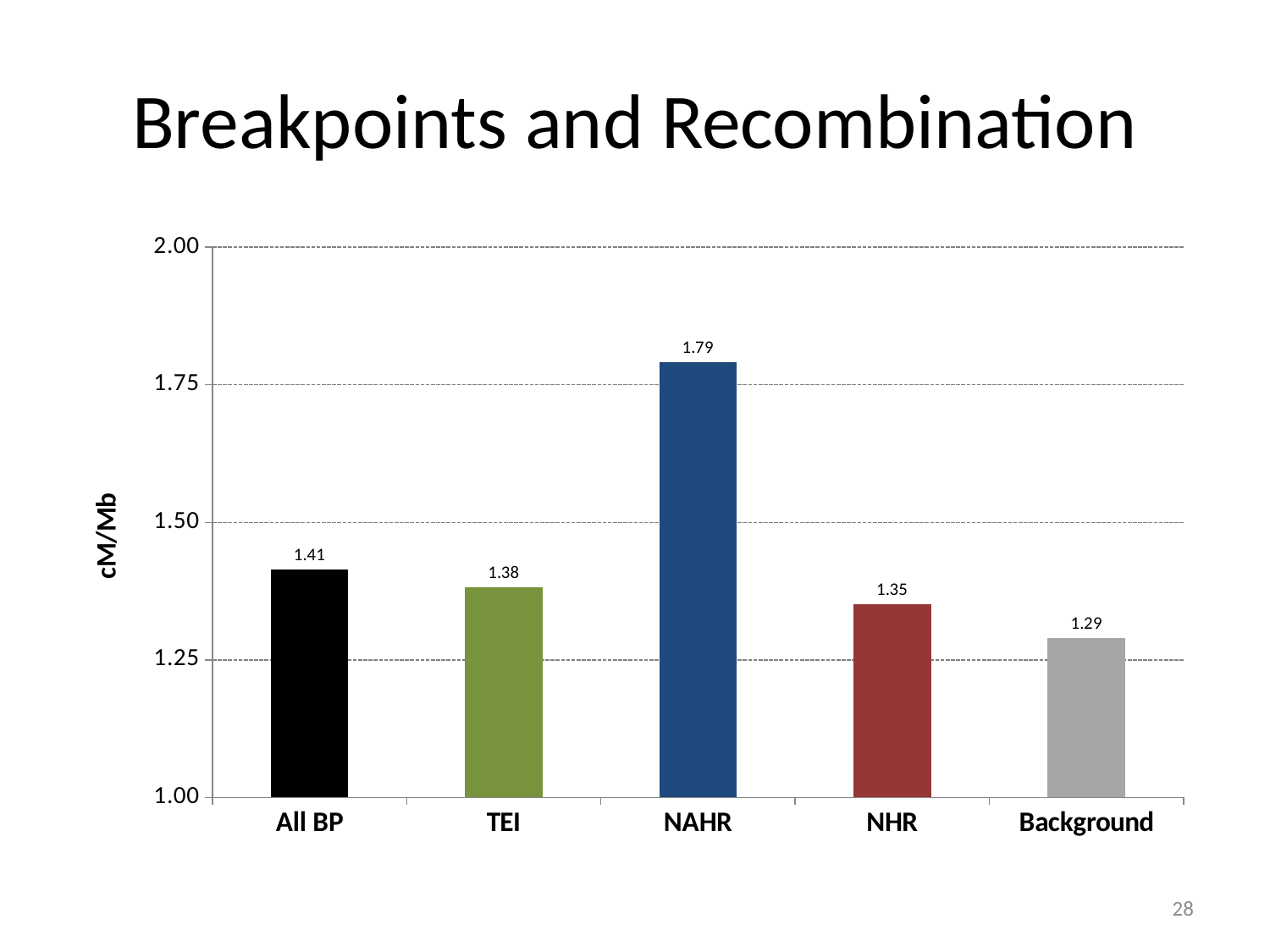
How many categories are shown on the x axis? 5 Which has a higher cM/Mb value, NAHR or NHR? NAHR What is the cM/Mb value for TEI? 1.38 What is the difference in cM/Mb between NAHR and Background? 0.50 What is the label of the y axis? cM/Mb What kind of chart is shown on the slide? bar chart Which category has the lowest cM/Mb value? Background What is the difference in cM/Mb between All BP and NHR? 0.06 What is the cM/Mb value for NAHR? 1.79 Which category has the highest cM/Mb value? NAHR What is the cM/Mb value for Background? 1.29 Is the value for NAHR greater or less than 1.75? greater